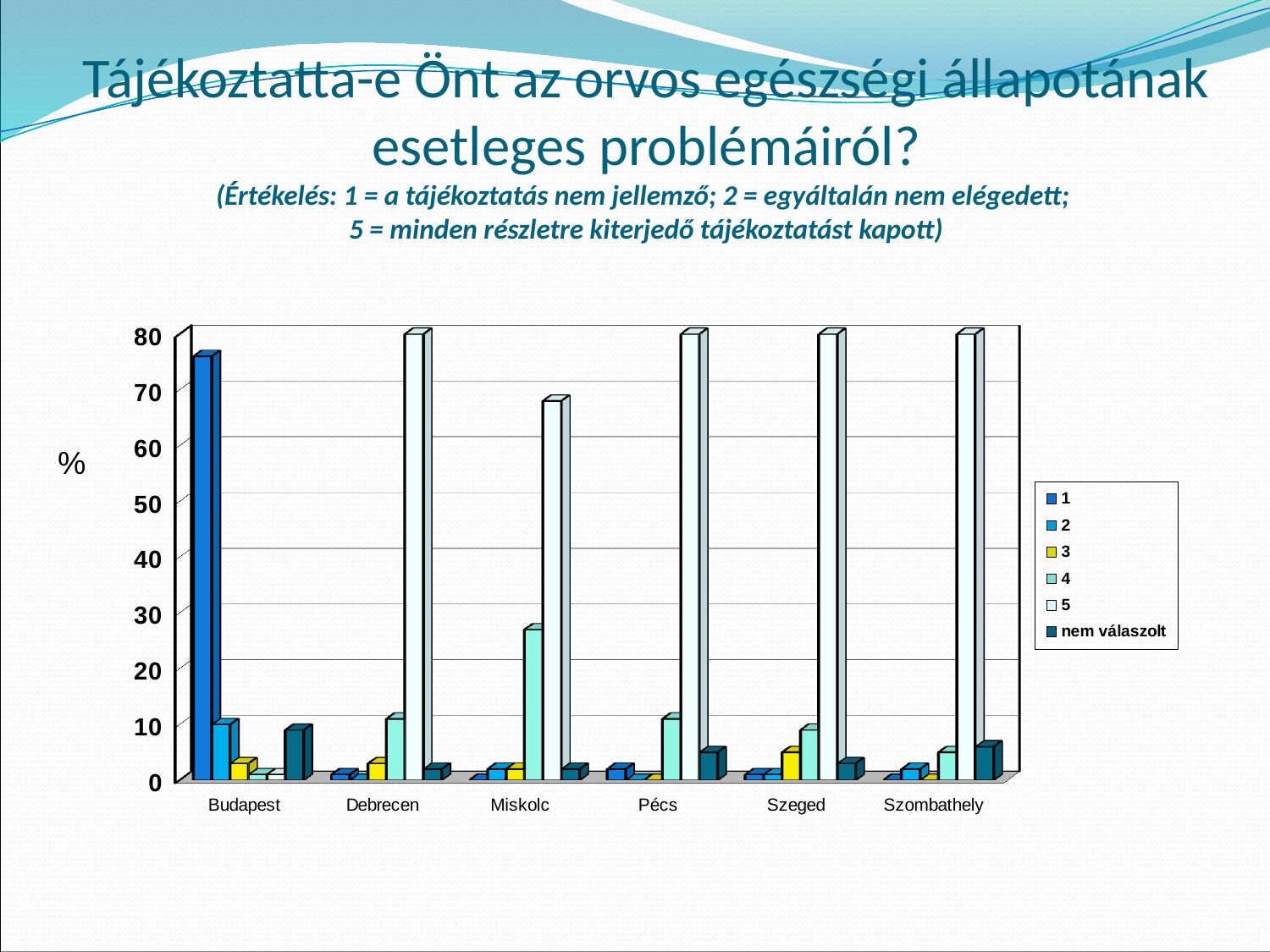
Is the value for series 1 in Budapest greater or less than 70? greater Which series has the highest value in Miskolc? 5 How many cities (categories) are shown on the x axis of the chart? 6 Which city has the highest value for series 1? Budapest How many series does the chart's legend list? 6 Which city has the lowest value for series 5? Budapest Is the value for series 2 in Budapest greater or less than 20? less Is the value for series 5 in Miskolc greater or less than 60? greater Which is larger: the value for series 4 in Miskolc or the value for series 2 in Budapest? series 4 in Miskolc What is the last entry listed in the chart's legend? nem válaszolt What kind of chart is shown on the slide? bar chart